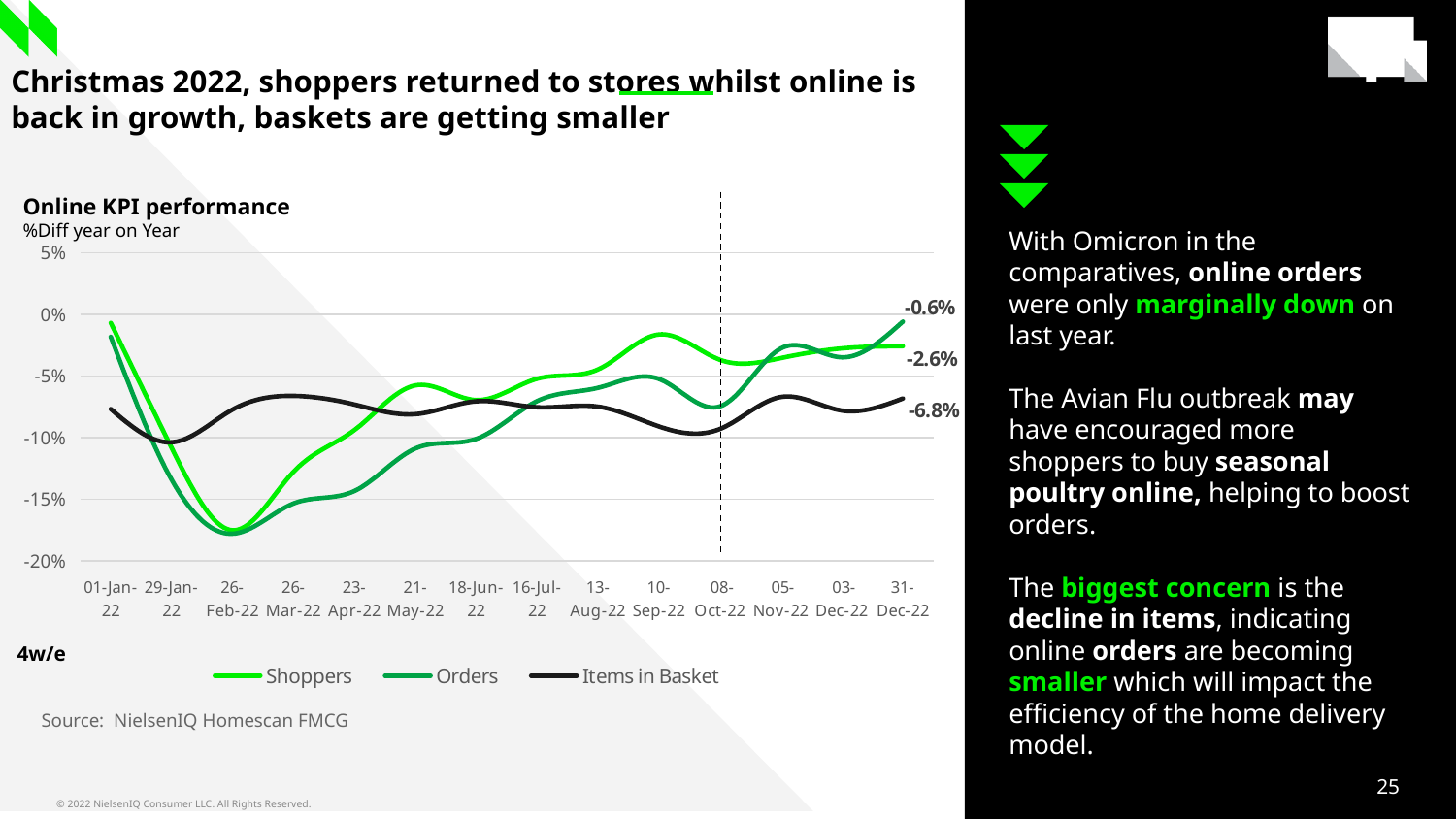
What kind of chart is shown on the slide? line chart At the end of the chart, which is higher: Orders or Shoppers? Orders Is the value for Shoppers at 26-Feb-22 greater or less than -15%? less Which series has the lowest value at the end of the chart? Items in Basket What is the difference between the final labelled values for Orders (-0.6%) and Items in Basket (-6.8%)? 6.2 percentage points How many date labels are shown on the x axis? 14 What is the final labelled value for Shoppers at the end of the chart? -2.6% How many series does the legend list? 3 Is the value for Items in Basket at 26-Mar-22 greater or less than -10%? greater What is the final labelled value for Orders at the end of the chart? -0.6% What is the final labelled value for Items in Basket at the end of the chart? -6.8% What is the source cited below the chart? NielsenIQ Homescan FMCG